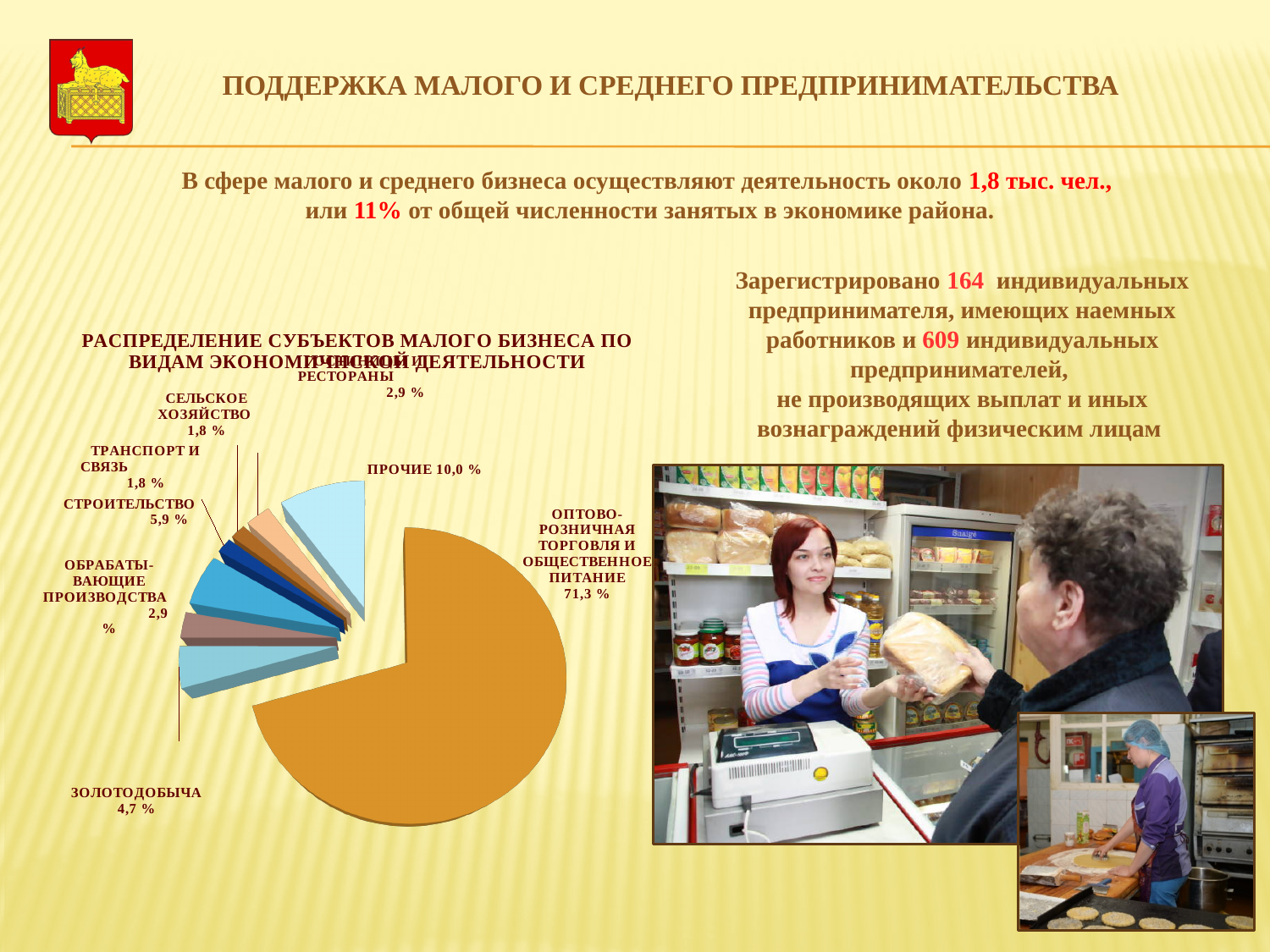
What is the title of the chart on the slide? РАСПРЕДЕЛЕНИЕ СУБЪЕКТОВ МАЛОГО БИЗНЕСА ПО ВИДАМ ЭКОНОМИЧЕСКОЙ ДЕЯТЕЛЬНОСТИ What type of chart is shown on the slide? pie chart What share of the pie does 'Оптово-розничная торговля и общественное питание' have? 71,3 % What is the difference between the shares of 'Прочие' and 'Строительство'? 4,1 % What is the value shown for 'Обрабатывающие производства'? 2,9 % What is the value shown for 'Прочие'? 10,0 % What is the value shown for 'Транспорт и связь'? 1,8 % Which category has the largest slice of the pie? Оптово-розничная торговля и общественное питание What is the value shown for 'Золотодобыча'? 4,7 % What is the difference between the shares of 'Золотодобыча' and 'Сельское хозяйство'? 2,9 % What is the value shown for 'Строительство'? 5,9 % Which is larger: 'Строительство' or 'Золотодобыча'? Строительство